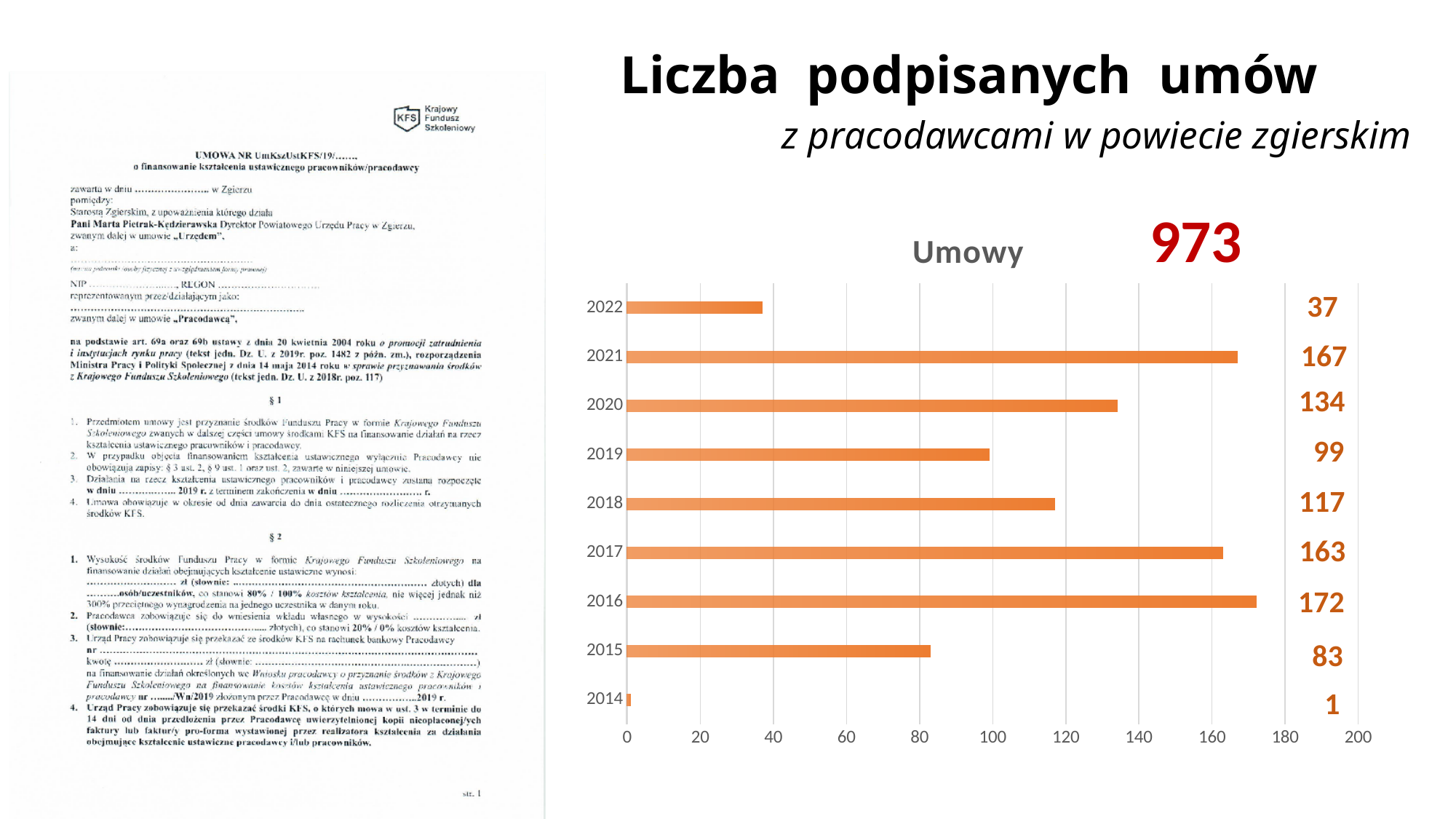
Which is larger, the value for 2018 or the value for 2020? 2020 What is the value for 2021? 167 What type of chart is shown on the slide? bar chart Which year has the highest value? 2016 How many years are shown in the chart? 9 What total number is printed next to the chart title? 973 What is the difference between the values for 2016 and 2022? 135 What is the value for 2019? 99 Is the value for 2015 greater or less than 100? less What is the value for 2014? 1 Which year has the lowest value? 2014 What is the title of the chart? Umowy